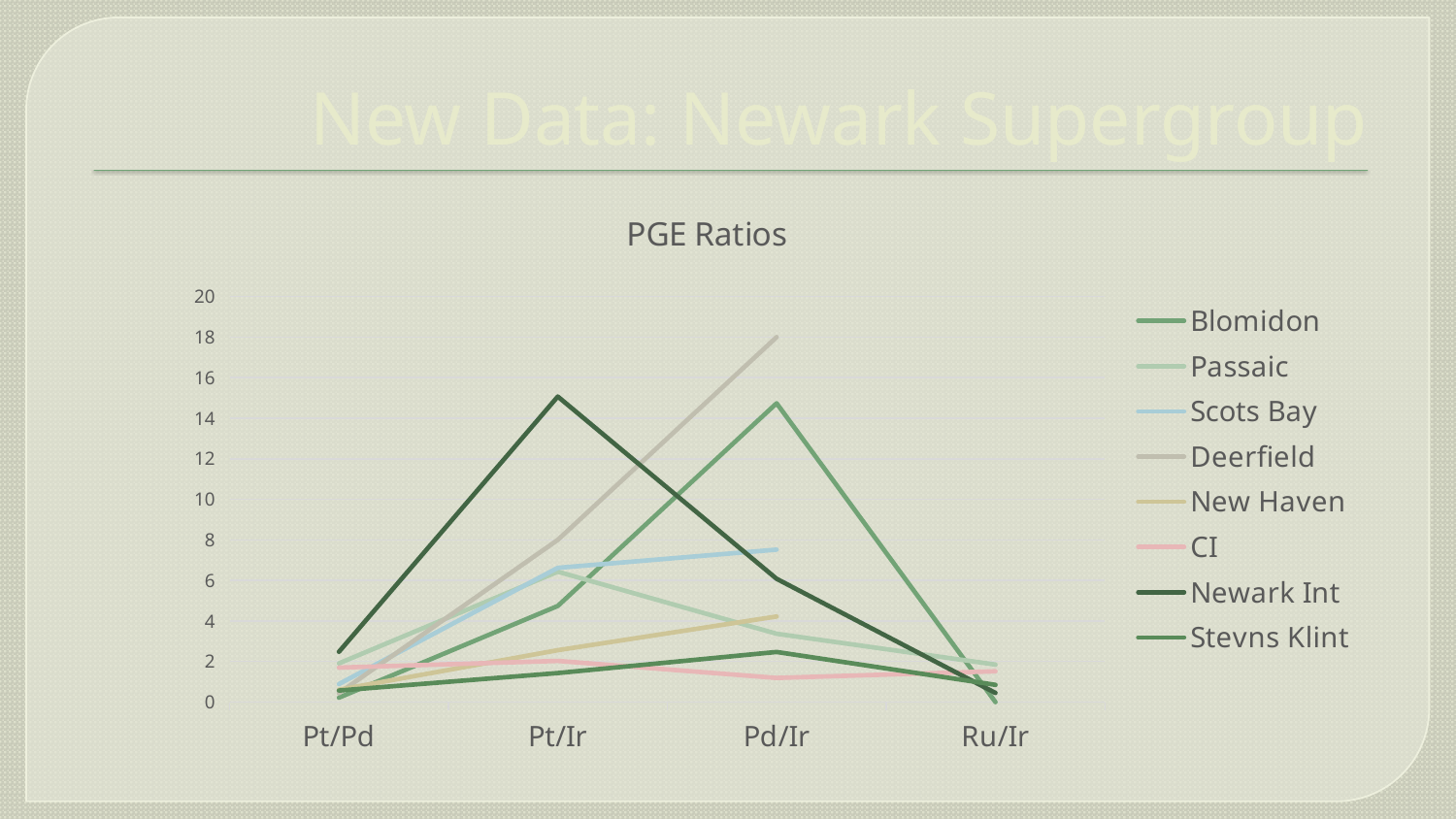
Is the value for Newark Int at Pt/Ir greater or less than 14? greater How many categories are shown on the x axis of the PGE Ratios chart? 4 Does the Newark Int line rise or fall from Pt/Ir to Ru/Ir? fall Is the value for Scots Bay at Pd/Ir greater or less than 10? less Is the value for Blomidon at Pd/Ir greater or less than 12? greater Which series has the highest value at Pd/Ir? Deerfield What is the title of the chart? PGE Ratios At Pt/Ir, which series has the larger value, Newark Int or Blomidon? Newark Int How many series does the legend of the PGE Ratios chart list? 8 What kind of chart is shown on the slide? line chart Which series has the highest value at Pt/Ir? Newark Int